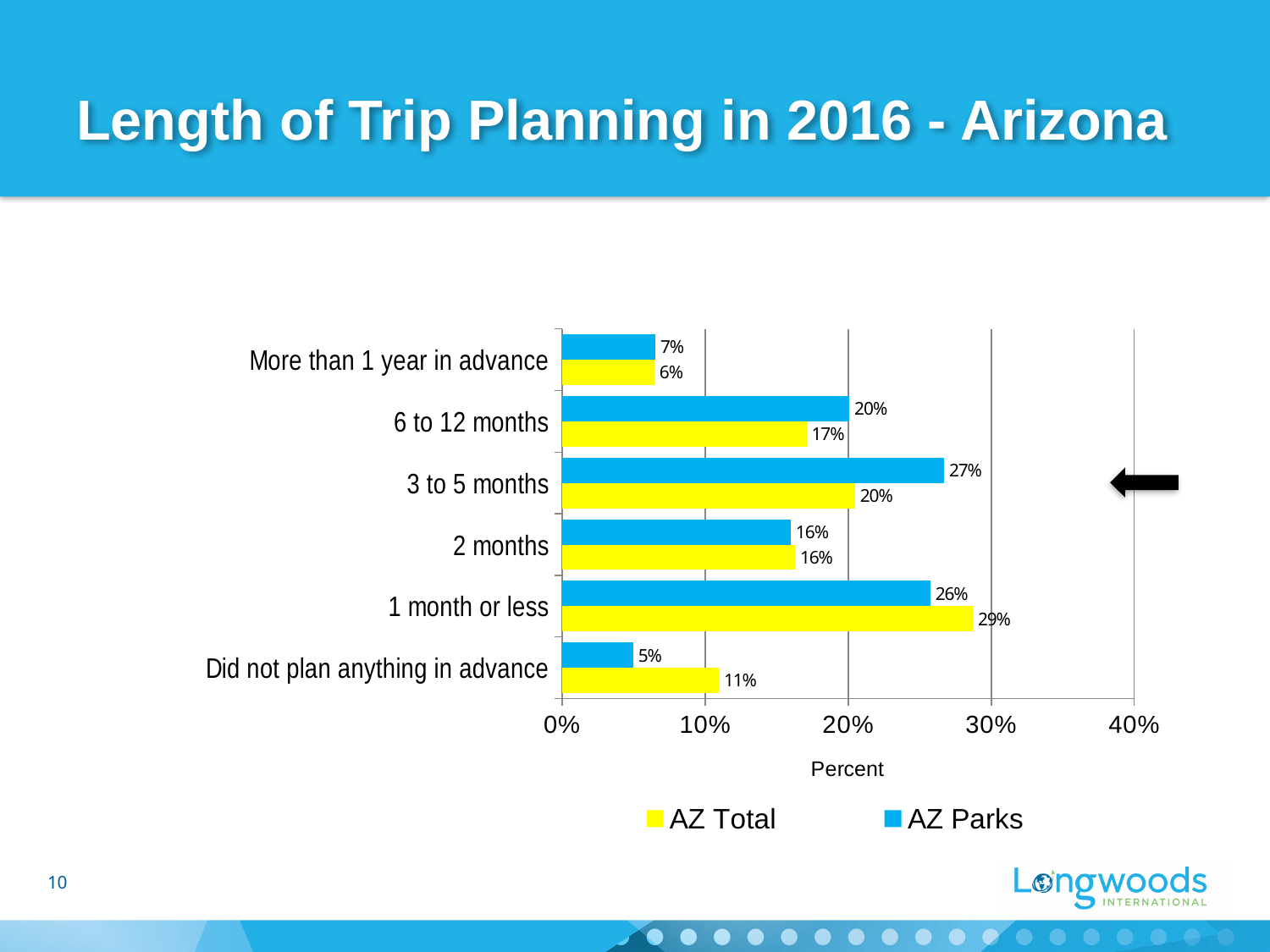
How many categories are shown on the chart? 6 What kind of chart is shown on the slide? Bar chart What is the AZ Total value for "1 month or less"? 29% What is the title of the chart? Length of Trip Planning in 2016 - Arizona What is the difference between the AZ Parks and AZ Total values for "3 to 5 months"? 7% Which category has the lowest AZ Total value? More than 1 year in advance How many series does the legend list? 2 What is the AZ Parks value for "3 to 5 months"? 27% What is the AZ Parks value for "6 to 12 months"? 20% What is the AZ Total value for "Did not plan anything in advance"? 11% Which is larger for "Did not plan anything in advance": AZ Total or AZ Parks? AZ Total Which category has the highest AZ Parks value? 3 to 5 months